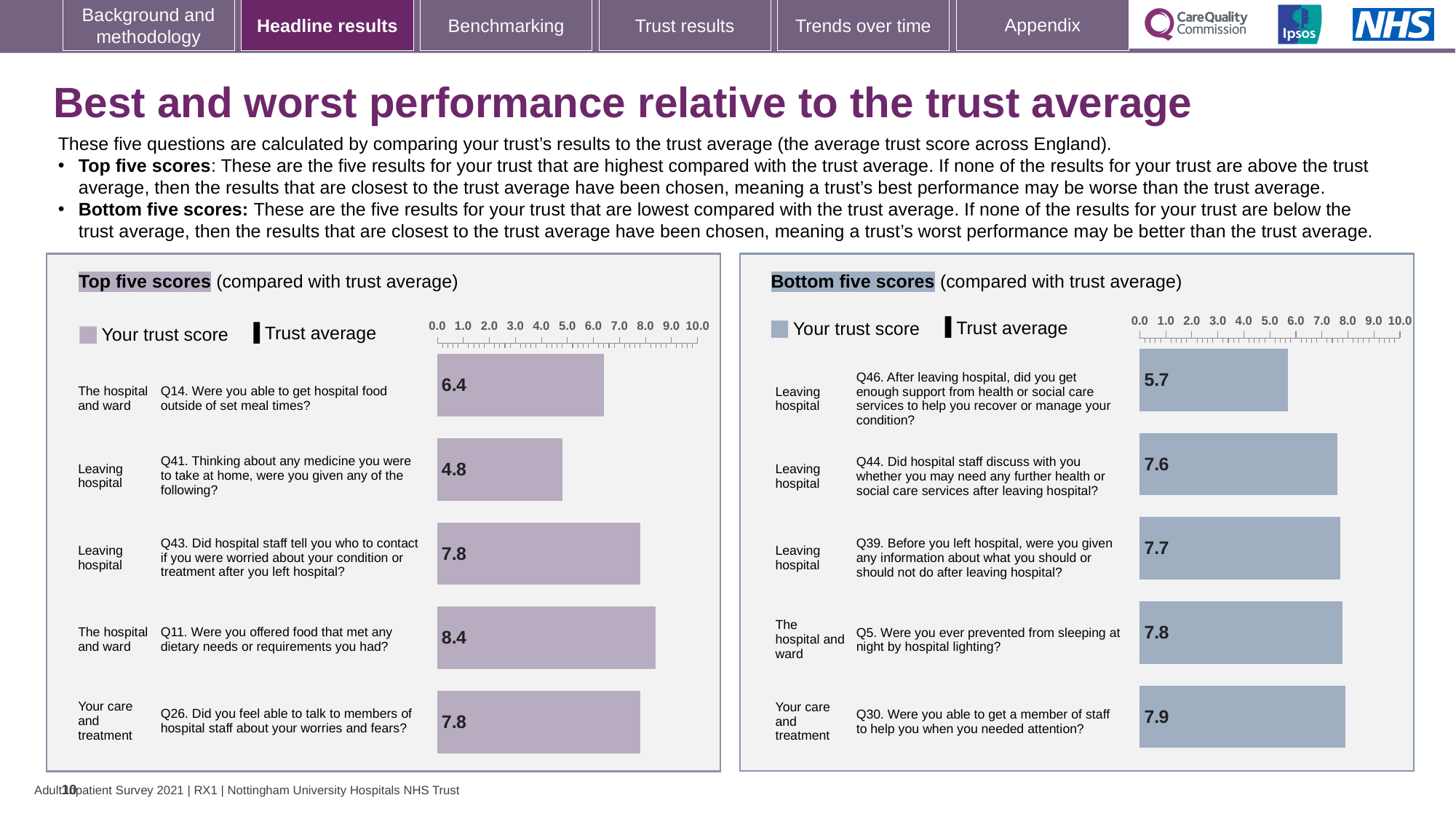
What type of chart is used in the Bottom five scores panel? Bar chart In the Top five scores chart, which question has the lowest trust score? Q41 In the Top five scores chart, what is the trust score for Q41 (medicine to take at home)? 4.8 In the Bottom five scores chart, what is the difference between the scores for Q30 and Q46? 2.2 In the Bottom five scores chart, which is larger: the score for Q44 or the score for Q5? Q5 In the Bottom five scores chart, what is the trust score for Q46 (support from health or social care services after leaving hospital)? 5.7 In the Top five scores chart, what is the trust score for Q14 (getting hospital food outside of set meal times)? 6.4 In the Bottom five scores chart, which question has the lowest trust score? Q46 In the Bottom five scores chart, what is the trust score for Q30 (getting a member of staff to help when you needed attention)? 7.9 In the Top five scores chart, which question has the highest trust score? Q11 How many questions are plotted in the Top five scores chart? 5 In the Top five scores chart, what is the difference between the scores for Q11 and Q41? 3.6